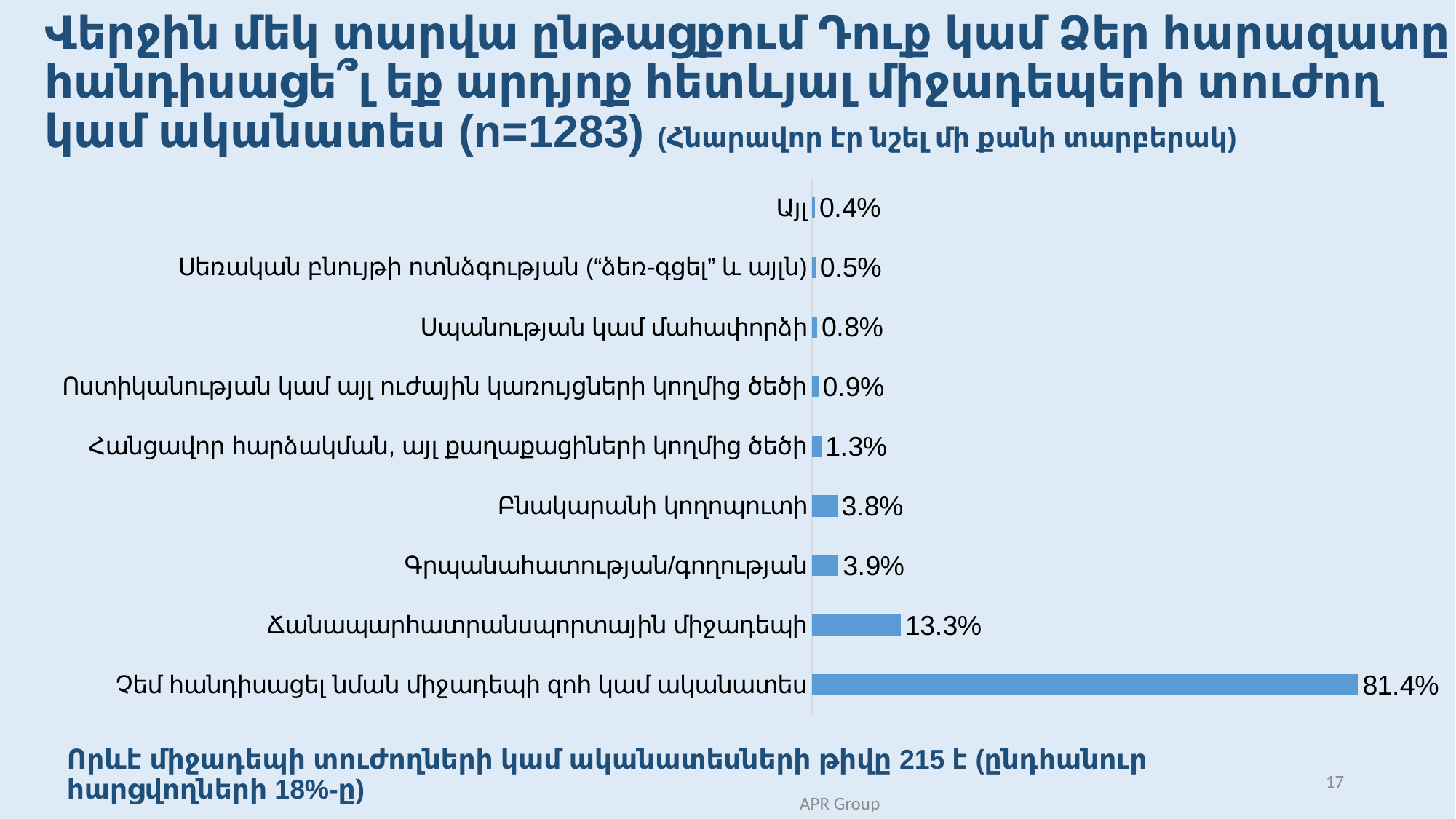
Which category has the lowest value? Այլ What is the value for "Սպանության կամ մահափորձի"? 0.8% What is the value for "Բնակարանի կողոպուտի"? 3.8% How many categories are shown in the chart? 9 What kind of chart is shown on the slide? Bar chart Which category has the highest value? Չեմ հանդիսացել նման միջադեպի զոհ կամ ականատես What is the difference between the values for "Ճանապարհատրանսպորտային միջադեպի" and "Գրպանահատության/գողության"? 9.4% What is the difference between the values for "Չեմ հանդիսացել նման միջադեպի զոհ կամ ականատես" and "Ճանապարհատրանսպորտային միջադեպի"? 68.1% What is the value for "Չեմ հանդիսացել նման միջադեպի զոհ կամ ականատես"? 81.4% What is the value for "Այլ"? 0.4% Which is larger: the value for "Հանցավոր հարձակման, այլ քաղաքացիների կողմից ծեծի" or the value for "Ոստիկանության կամ այլ ուժային կառույցների կողմից ծեծի"? Հանցավոր հարձակման, այլ քաղաքացիների կողմից ծեծի What is the value for "Ճանապարհատրանսպորտային միջադեպի"? 13.3%